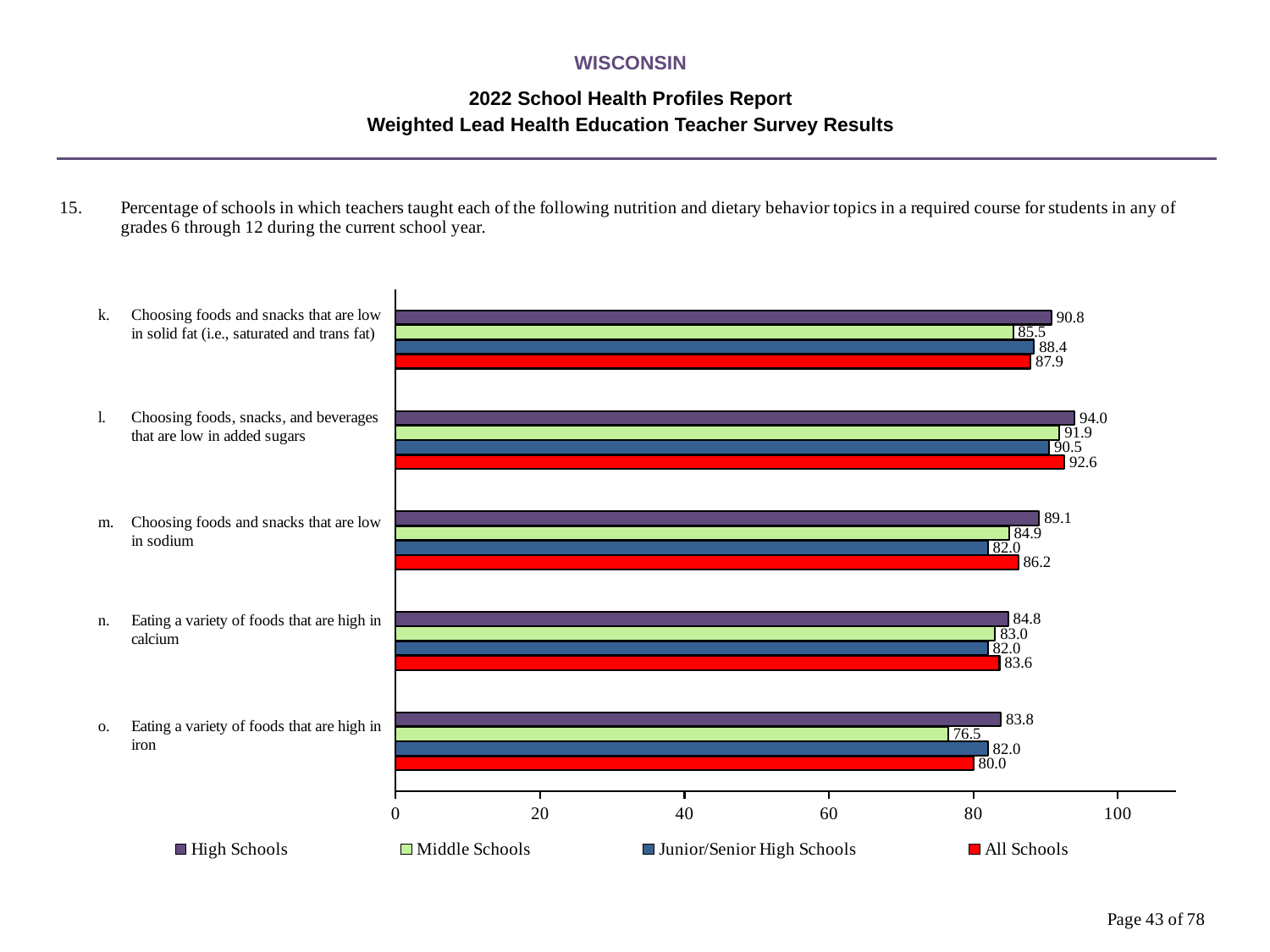
Which series is shown in red in the legend? All Schools How many nutrition and dietary behavior topics are shown on the chart? 5 How many series does the legend list? 4 What is the All Schools value for topic m, choosing foods and snacks that are low in sodium? 86.2 What kind of chart is shown on the slide? Bar chart For topic n, eating a variety of foods that are high in calcium, which is larger: the High Schools value or the Junior/Senior High Schools value? High Schools What is the difference between the High Schools and Middle Schools values for topic k, choosing foods and snacks that are low in solid fat? 5.3 Which topic has the highest All Schools value? l. Choosing foods, snacks, and beverages that are low in added sugars Which topic has the lowest Middle Schools value? o. Eating a variety of foods that are high in iron What is the value for High Schools for topic l, choosing foods, snacks, and beverages that are low in added sugars? 94.0 Is the All Schools value for topic o, eating a variety of foods that are high in iron, greater or less than 90? less What is the value for Middle Schools for topic o, eating a variety of foods that are high in iron? 76.5